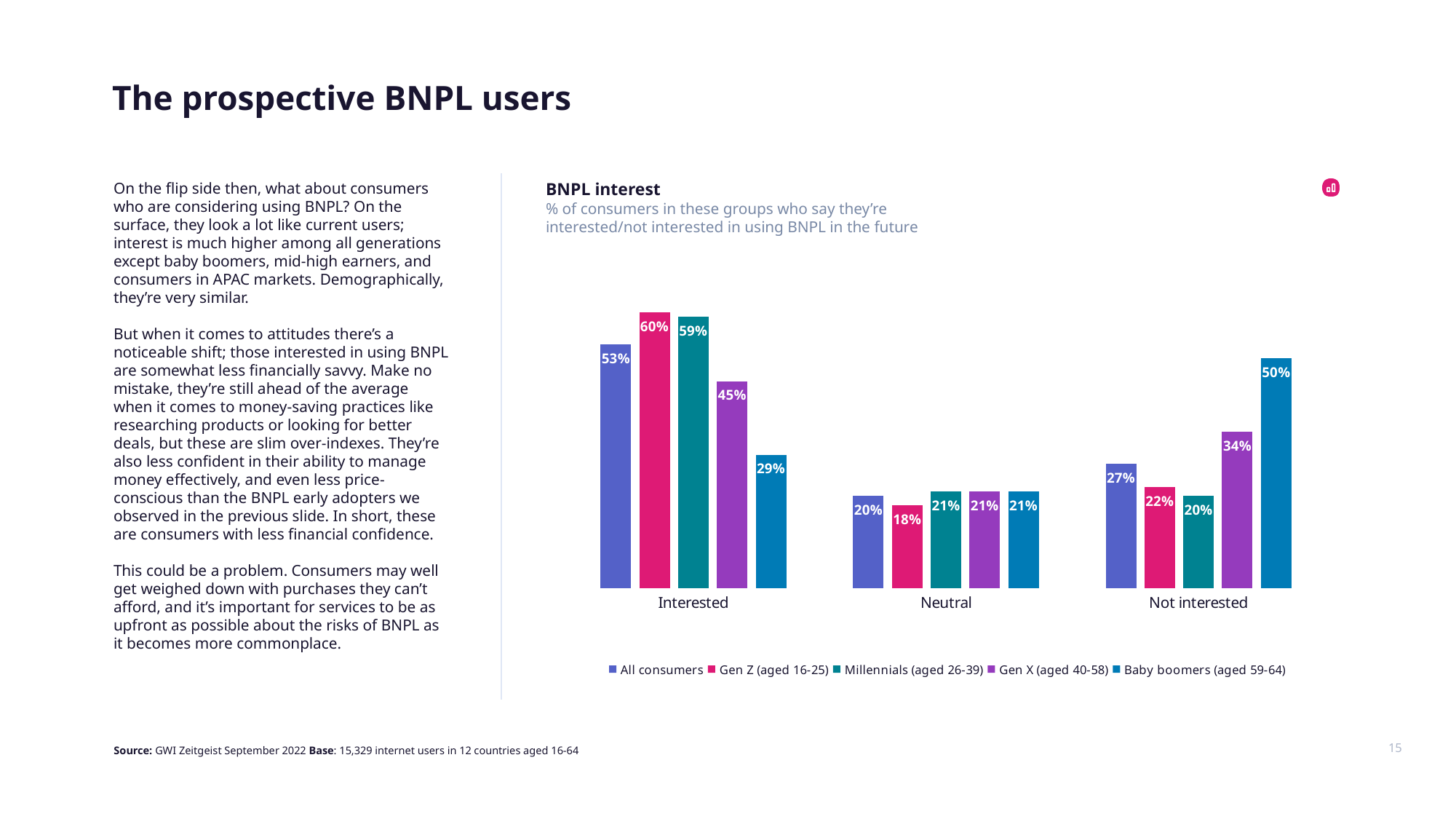
What is the difference between the Not interested values for Baby boomers (aged 59-64) and Gen X (aged 40-58)? 16% How many series does the legend list? 5 Which group has the highest value in the Interested category? Gen Z (aged 16-25) In the Not interested category, which is larger: Gen X (aged 40-58) or All consumers? Gen X (aged 40-58) What is the title of the chart? BNPL interest Which group has the lowest value in the Not interested category? Millennials (aged 26-39) What percentage of Gen Z (aged 16-25) consumers are Interested in using BNPL? 60% What is the value for Baby boomers (aged 59-64) in the Not interested category? 50% What is the value for All consumers in the Neutral category? 20% How many categories are shown on the x axis? 3 What kind of chart is shown on the slide? Bar chart What is the difference between the Interested values for Gen Z (aged 16-25) and Baby boomers (aged 59-64)? 31%